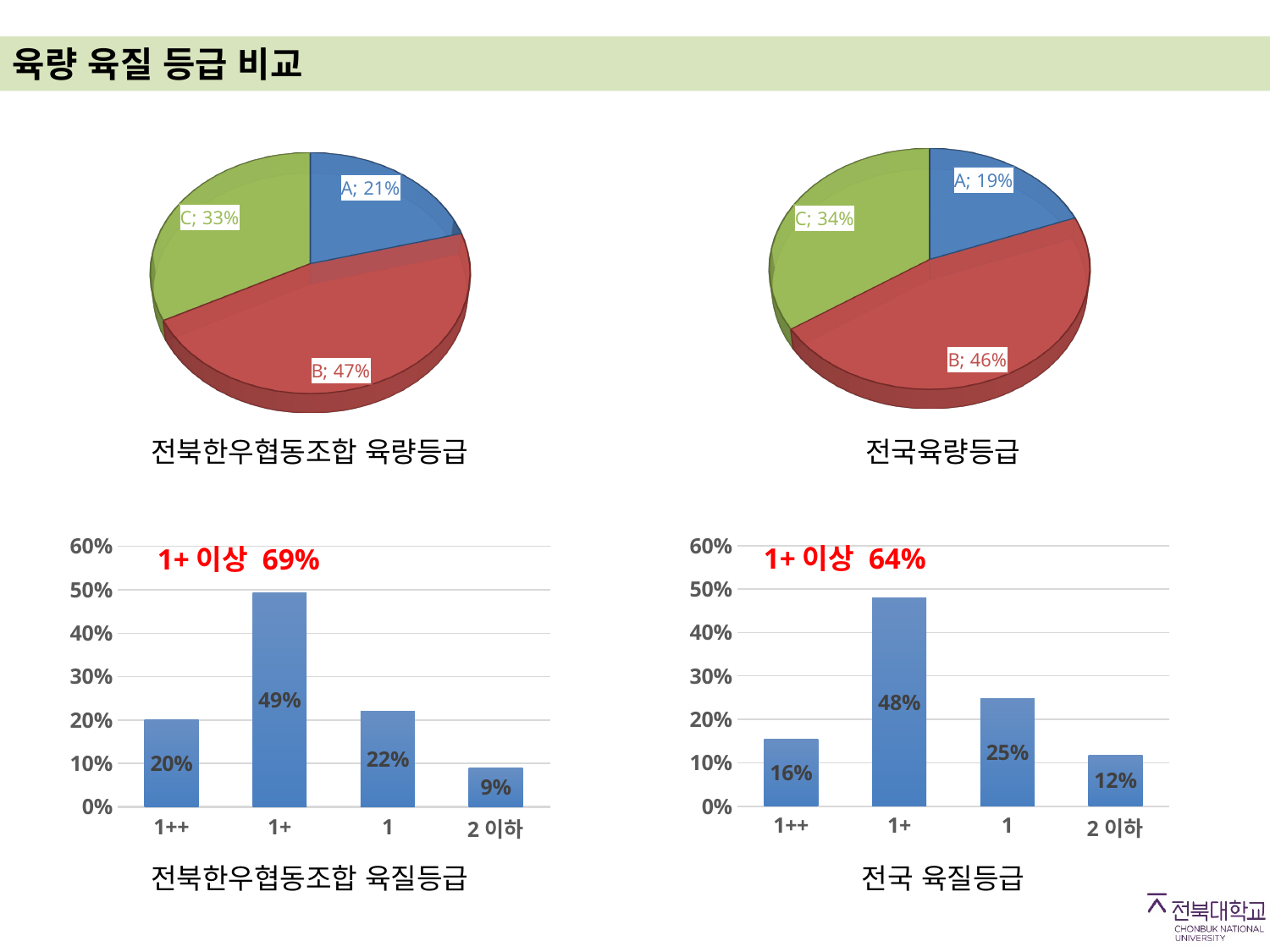
In the top-left pie chart (전북한우협동조합 육량등급), what share does grade B have? 47% Which is larger: the value for 1++ in the bottom-left bar chart (전북한우협동조합 육질등급) or the value for 1++ in the bottom-right bar chart (전국 육질등급)? 전북한우협동조합 육질등급 (20%) In the bottom-left bar chart (전북한우협동조합 육질등급), which category has the lowest value? 2 이하 In the bottom-right bar chart (전국 육질등급), what is the value for 2 이하? 12% In the top-left pie chart (전북한우협동조합 육량등급), which grade has the largest share? B What type of chart is the bottom-right chart (전국 육질등급)? Bar chart In the bottom-left bar chart (전북한우협동조합 육질등급), what is the difference between the values for 1+ and 1? 27% In the top-right pie chart (전국육량등급), what share does grade A have? 19% In the top-right pie chart (전국육량등급), which grade has the smallest share? A In the bottom-right bar chart (전국 육질등급), which category has the highest value? 1+ In the bottom-left bar chart (전북한우협동조합 육질등급), what is the value for 1+? 49% How many slices does the top-right pie chart (전국육량등급) have? 3